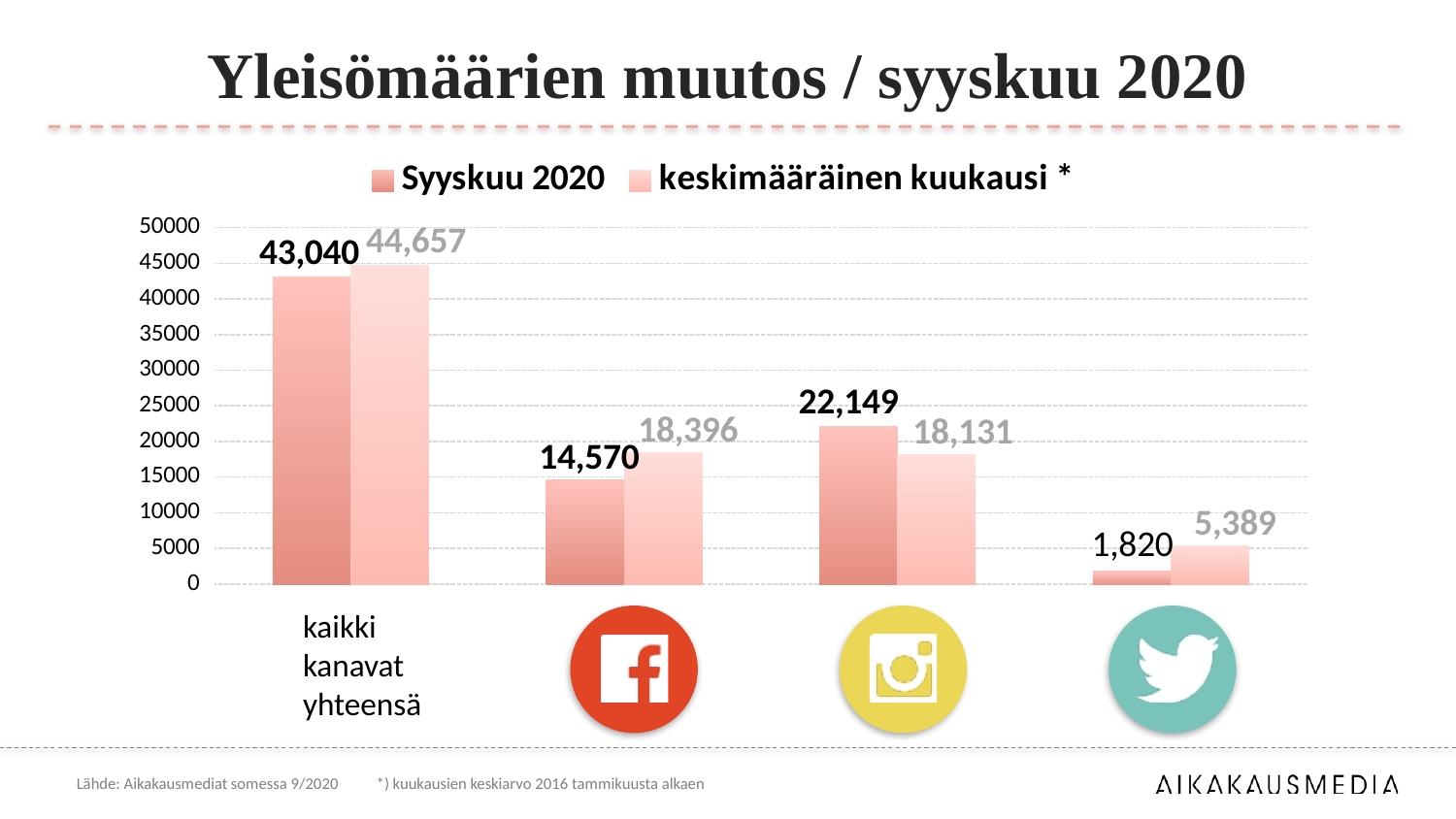
What is the keskimääräinen kuukausi value for kaikki kanavat yhteensä? 44,657 What is the Syyskuu 2020 value for the Twitter category? 1,820 What is the Syyskuu 2020 value for kaikki kanavat yhteensä? 43,040 What is the difference between the keskimääräinen kuukausi and Syyskuu 2020 values for the Facebook category? 3,826 Which category has the lowest Syyskuu 2020 value? Twitter What is the title of the slide? Yleisömäärien muutos / syyskuu 2020 What kind of chart is shown on the slide? bar chart How many series does the legend list? 2 For the Instagram category, which is larger: the Syyskuu 2020 value or the keskimääräinen kuukausi value? Syyskuu 2020 How many categories are shown on the x axis? 4 What is the keskimääräinen kuukausi value for the Instagram category? 18,131 What is the Syyskuu 2020 value for the Facebook category? 14,570